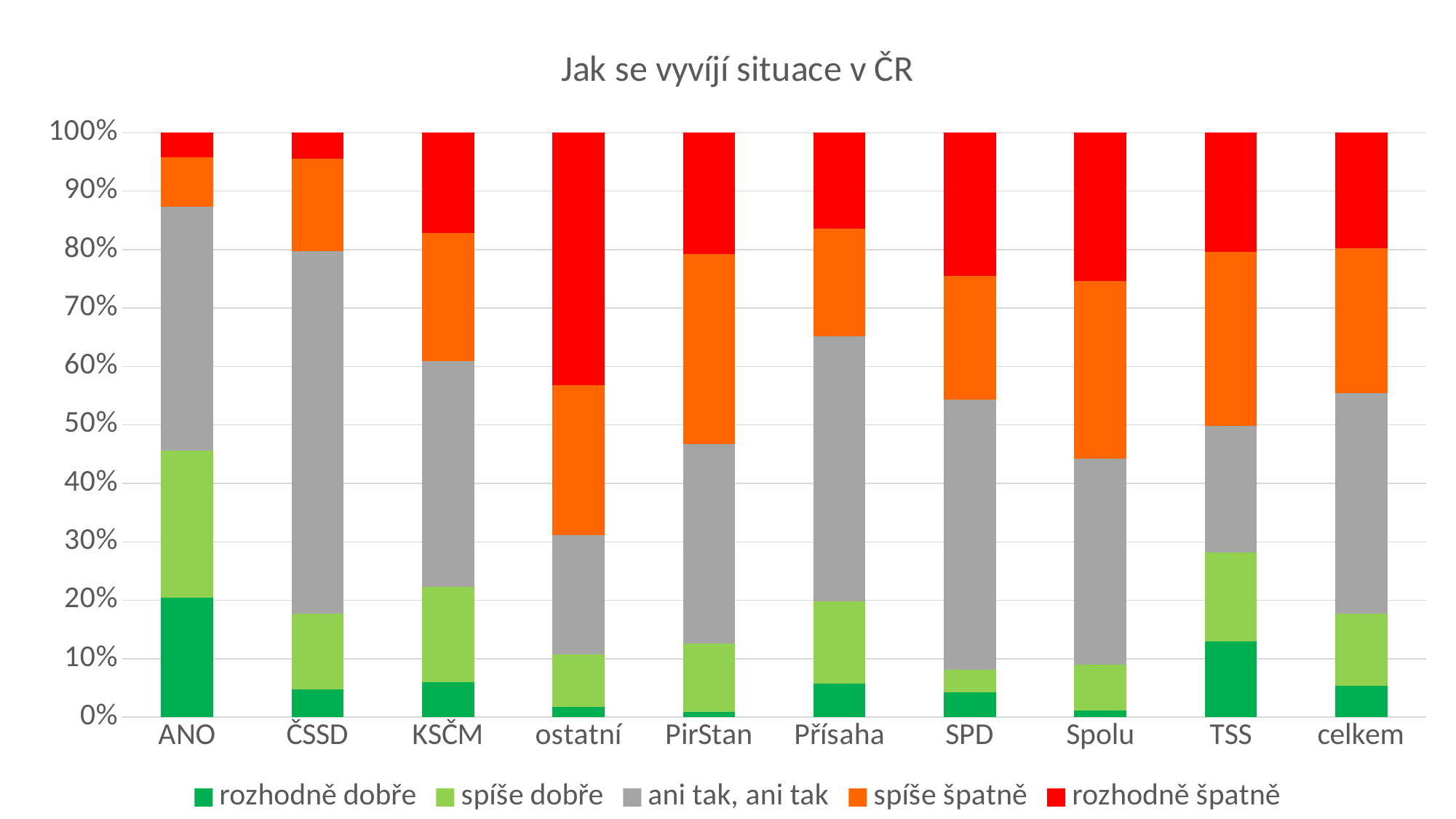
Is the 'rozhodně dobře' value for ANO greater or less than 10%? greater What colour represents the 'rozhodně špatně' series in the legend? red Which category has the largest 'rozhodně špatně' share? ostatní How many series does the legend list? 5 Which is larger, the 'rozhodně dobře' share for ANO or for TSS? ANO Which category has the largest 'rozhodně dobře' share? ANO Is the 'rozhodně špatně' value for ostatní greater or less than 30%? greater How many categories are shown on the x axis of the chart? 10 What is the title of the chart? Jak se vyvíjí situace v ČR What kind of chart is shown on the slide? stacked bar chart Which category has the largest 'ani tak, ani tak' share? ČSSD Is the 'rozhodně dobře' value for Spolu greater or less than 10%? less